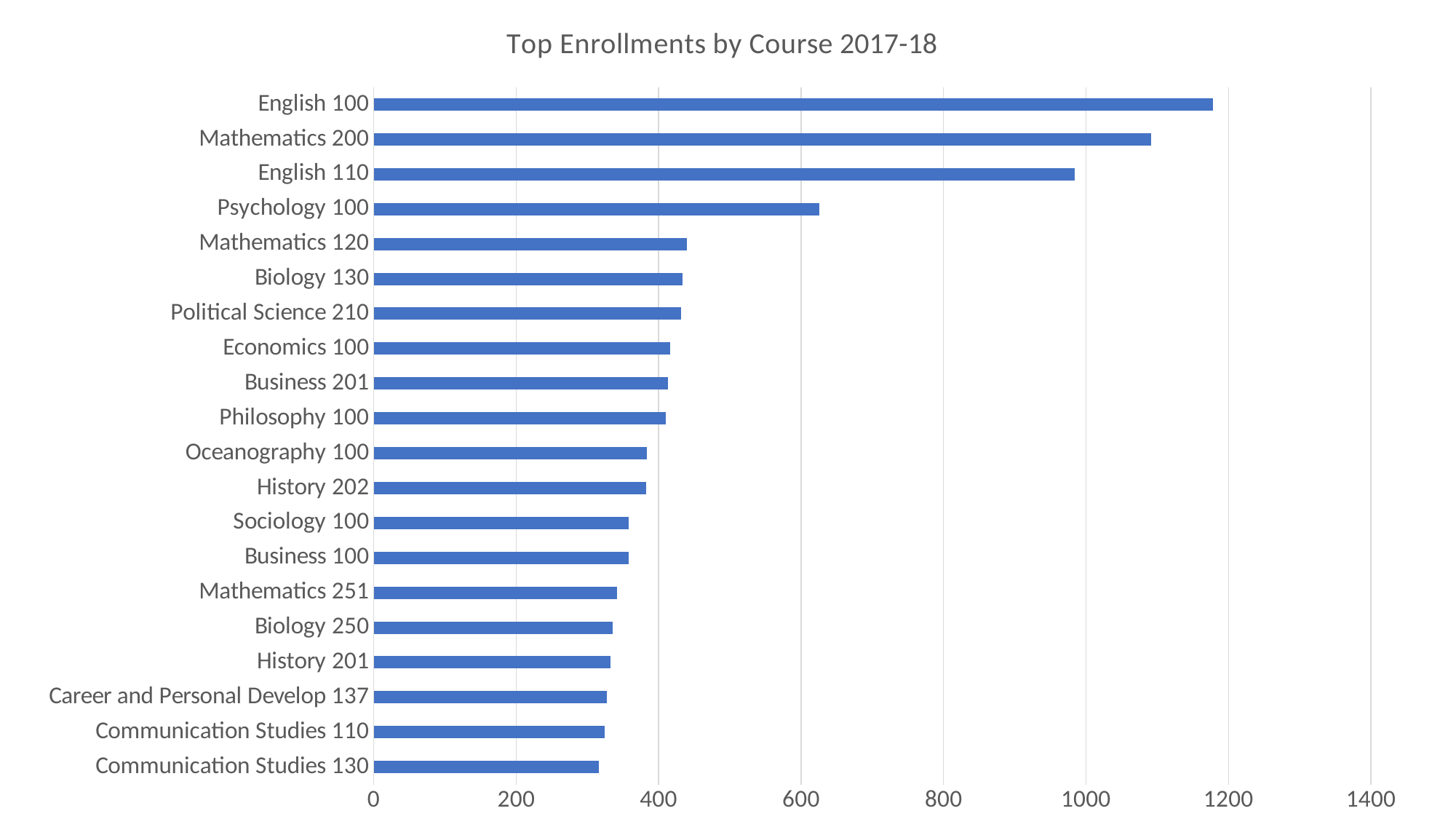
Is the value for Mathematics 200 greater or less than 1000? greater Is the value for Psychology 100 greater or less than 600? greater Is the value for Communication Studies 130 greater or less than 200? greater Which has the larger enrollment, History 202 or Mathematics 251? History 202 How many courses are plotted in the chart? 20 What is the title of the chart? Top Enrollments by Course 2017-18 Which course has the highest enrollment? English 100 What kind of chart is shown on the slide? bar chart Which has the larger enrollment, Psychology 100 or Mathematics 120? Psychology 100